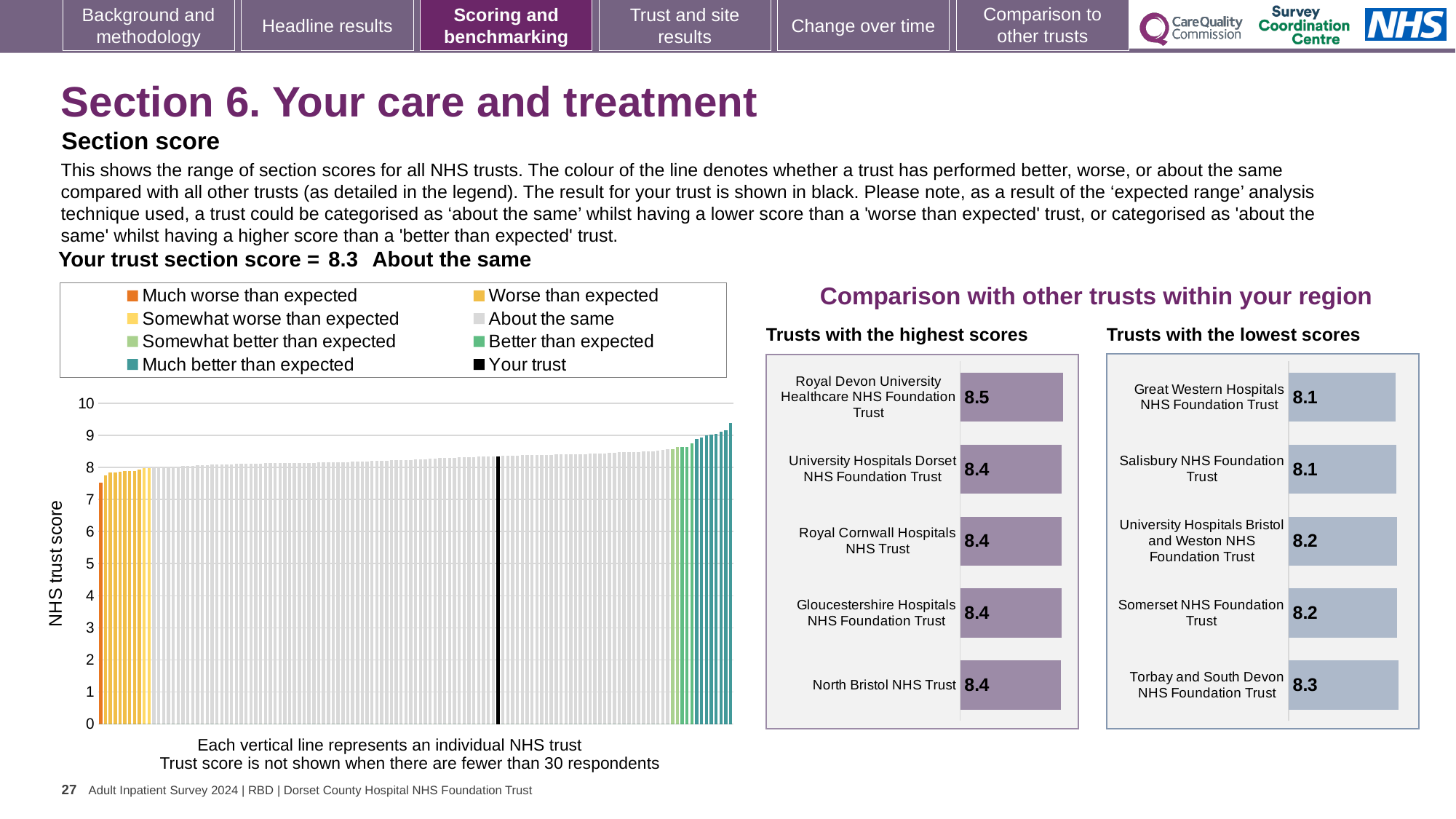
In the 'Trusts with the lowest scores' chart, what is the score for Somerset NHS Foundation Trust? 8.2 In the 'Trusts with the lowest scores' chart, which has the larger score: Torbay and South Devon NHS Foundation Trust or Great Western Hospitals NHS Foundation Trust? Torbay and South Devon NHS Foundation Trust In the main chart on the left, do the trust scores rise or fall from left to right along the x axis? Rise In the main chart on the left, is the value of the rightmost (highest) bar greater or less than 9? greater In the 'Trusts with the highest scores' chart, what is the difference between the scores of Royal Devon University Healthcare NHS Foundation Trust and North Bristol NHS Trust? 0.1 What kind of chart is the main chart on the left showing NHS trust scores? Bar chart In the 'Trusts with the highest scores' chart, how many trusts are shown? 5 In the 'Trusts with the lowest scores' chart, what is the difference between the scores of Torbay and South Devon NHS Foundation Trust and Salisbury NHS Foundation Trust? 0.2 In the 'Trusts with the lowest scores' chart, which trust has the highest score? Torbay and South Devon NHS Foundation Trust In the 'Trusts with the highest scores' chart, what is the score for Royal Devon University Healthcare NHS Foundation Trust? 8.5 In the 'Trusts with the highest scores' chart, which trust has the highest score? Royal Devon University Healthcare NHS Foundation Trust In the main chart on the left showing NHS trust scores, how many entries does the legend list? 8